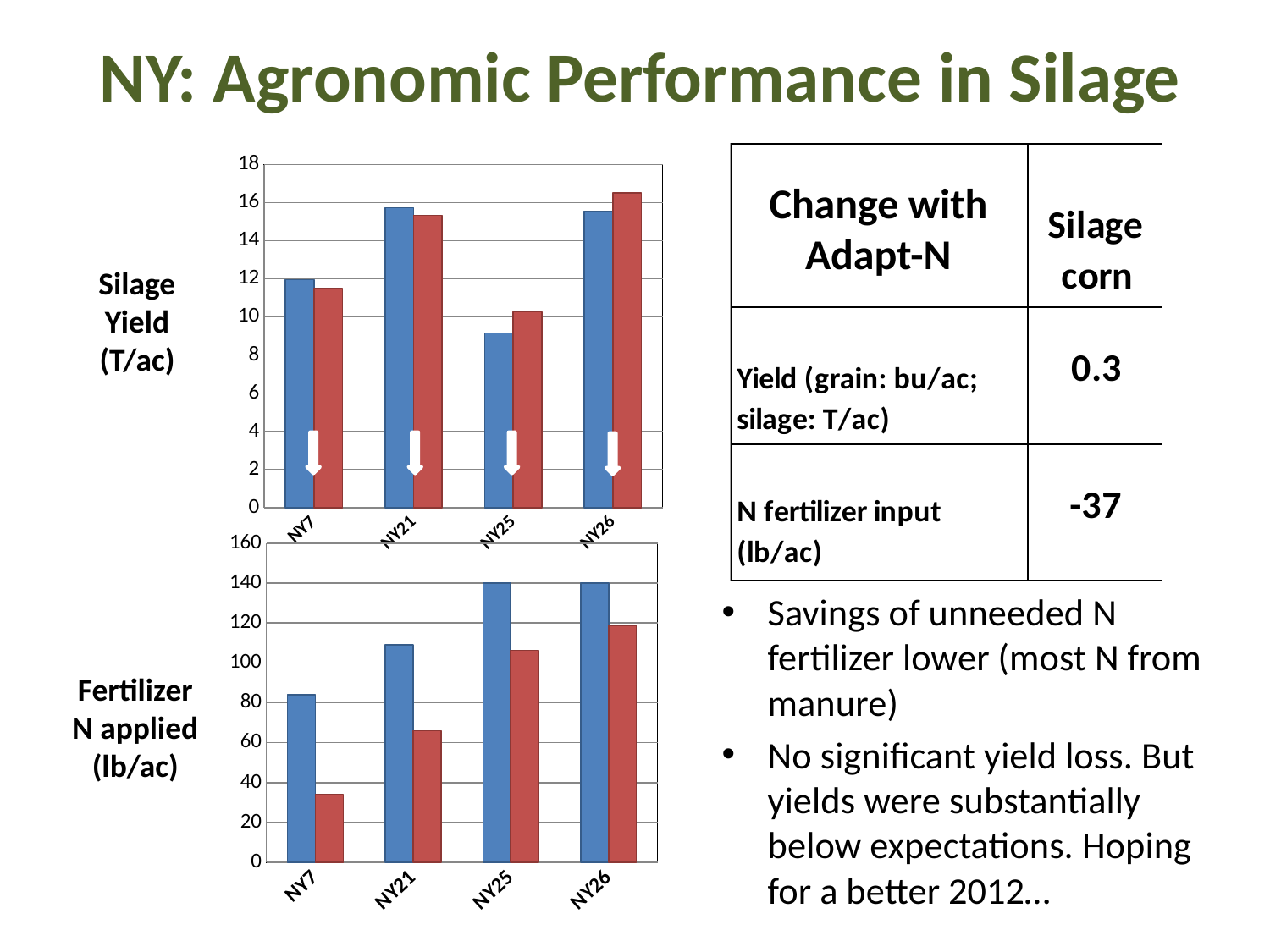
In the bottom chart (Fertilizer N applied), which category has the lowest red bar? NY7 What kind of chart is the top chart (Silage Yield)? bar chart How many categories are shown on the x axis of the bottom chart (Fertilizer N applied)? 4 In the bottom chart (Fertilizer N applied), is the blue bar for NY25 greater or less than 120? greater What is the y-axis label of the top chart? Silage Yield (T/ac) In the top chart (Silage Yield), is the blue bar for NY25 greater or less than 10? less In the bottom chart (Fertilizer N applied), is the red bar for NY26 greater or less than 100? greater In the top chart (Silage Yield), which category has the lowest blue bar? NY25 In the bottom chart (Fertilizer N applied), for NY7, is the blue bar or the red bar larger? blue